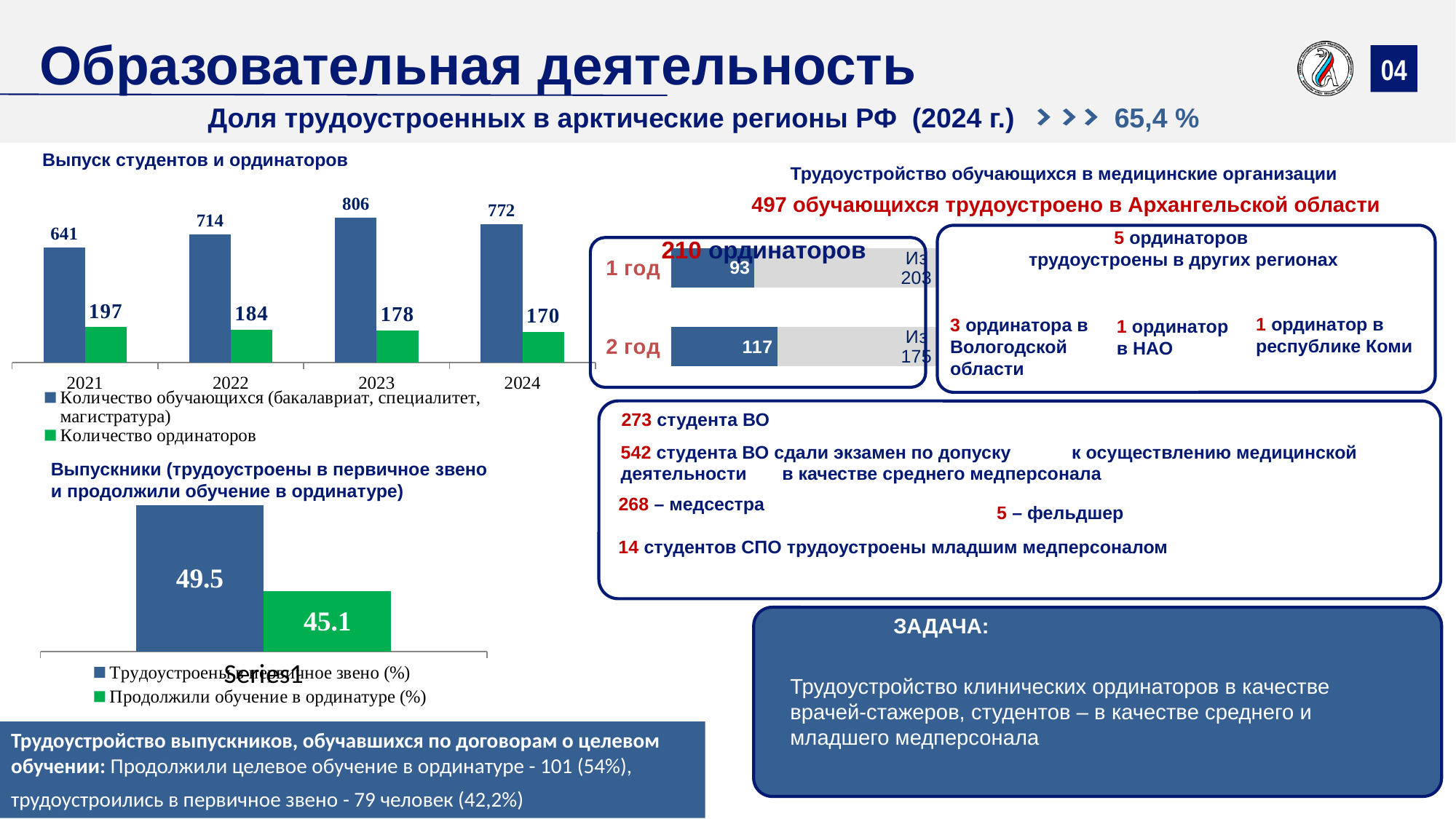
In the chart 'Выпускники (трудоустроены в первичное звено и продолжили обучение в ординатуре)', which is larger: 'Трудоустроены в первичное звено (%)' or 'Продолжили обучение в ординатуре (%)'? Трудоустроены в первичное звено (%) In the chart 'Выпуск студентов и ординаторов', which year has the lowest value for 'Количество ординаторов'? 2024 In the chart 'Выпуск студентов и ординаторов', what is the value for 'Количество ординаторов' in 2021? 197 In the chart 'Выпуск студентов и ординаторов', what is the value for 'Количество обучающихся (бакалавриат, специалитет, магистратура)' in 2023? 806 In the chart 'Выпуск студентов и ординаторов', does the 'Количество ординаторов' series rise or fall from 2021 to 2024? fall In the chart 'Выпуск студентов и ординаторов', what is the difference between the 'Количество обучающихся' values for 2024 and 2021? 131 In the chart 'Выпуск студентов и ординаторов', how many series does the legend list? 2 What kind of chart is 'Выпуск студентов и ординаторов'? bar chart In the chart 'Выпуск студентов и ординаторов', which year has the highest value for 'Количество обучающихся (бакалавриат, специалитет, магистратура)'? 2023 In the chart 'Выпускники (трудоустроены в первичное звено и продолжили обучение в ординатуре)', what is the value for 'Трудоустроены в первичное звено (%)'? 49.5 In the chart 'Выпуск студентов и ординаторов', how many years are shown on the x axis? 4 In the chart '210 ординаторов', what is the value for '2 год'? 117